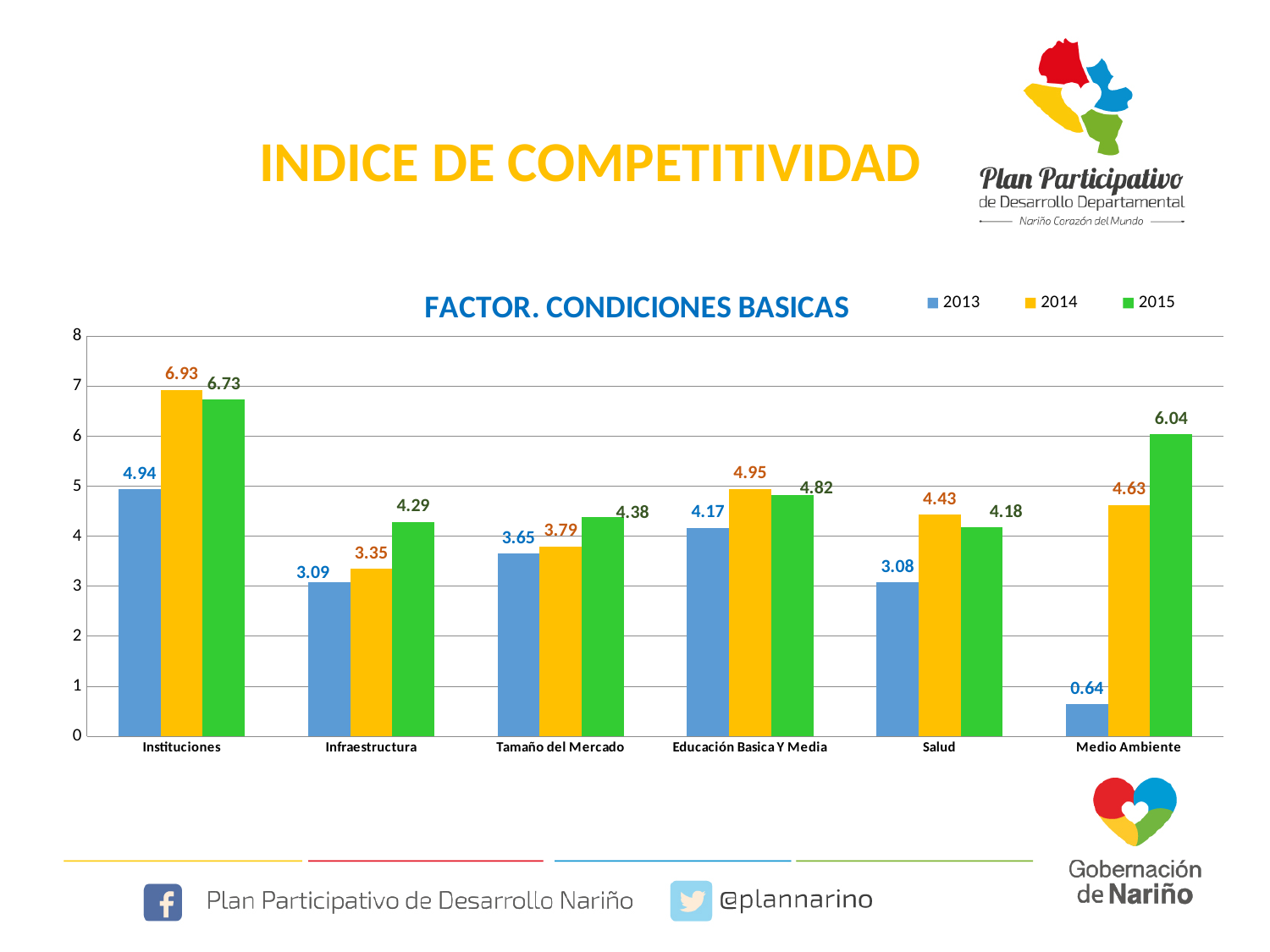
How many series does the legend list? 3 What is the 2013 value for Medio Ambiente? 0.64 What is the difference between the 2015 and 2014 values for Medio Ambiente? 1.41 Which is larger for Salud: the 2014 value or the 2015 value? 2014 What is the 2015 value for Infraestructura? 4.29 Which category has the lowest 2013 value? Medio Ambiente What is the title of the chart? FACTOR. CONDICIONES BASICAS What is the 2014 value for Instituciones? 6.93 What kind of chart is shown? bar chart How many categories are shown on the x axis? 6 Do the values for Tamaño del Mercado rise or fall from 2013 to 2015? rise Which category has the highest 2015 value? Instituciones